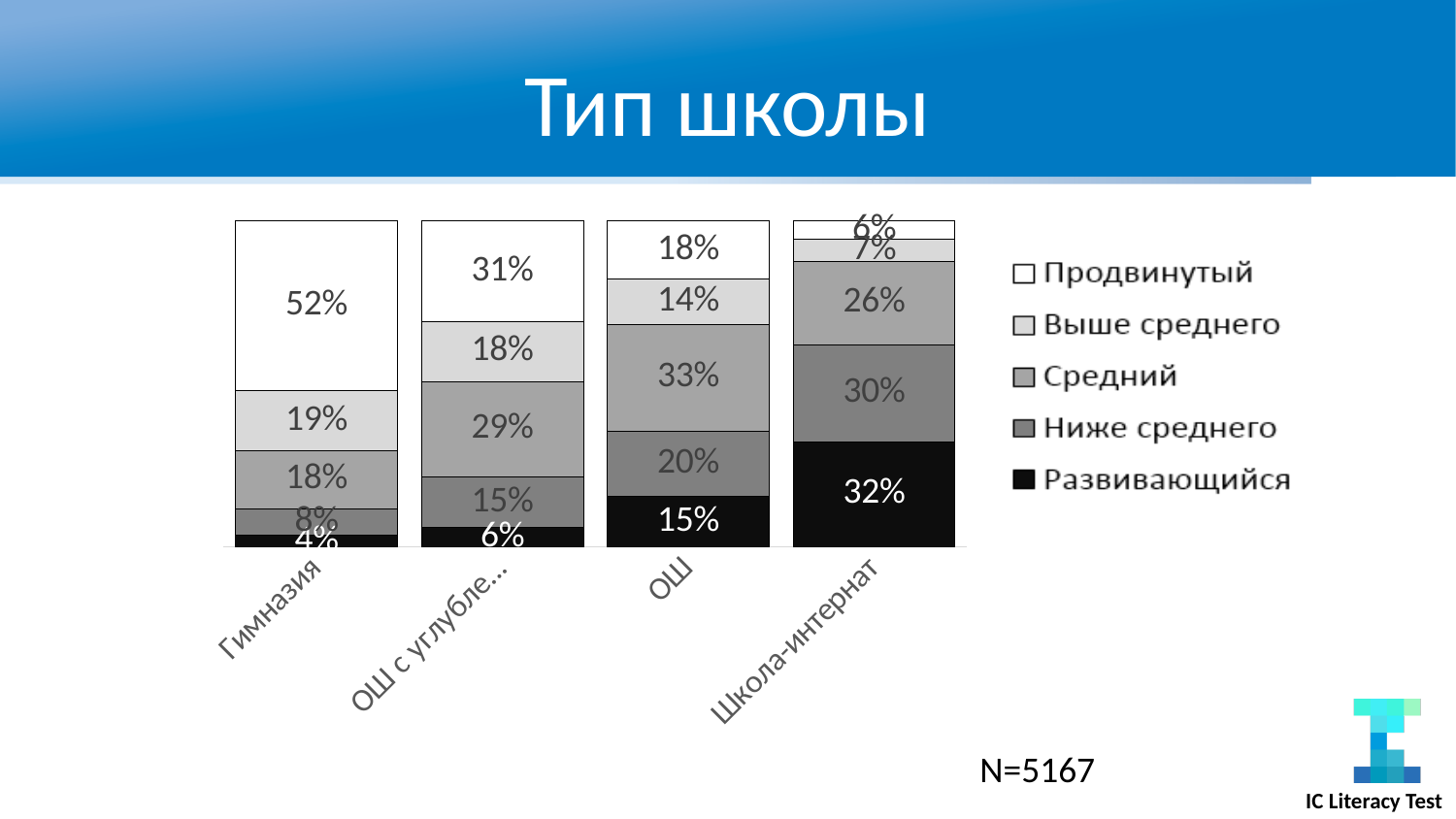
What is the difference between the Продвинутый values for Гимназия and ОШ? 34 percentage points Which has a larger Средний value, ОШ or Гимназия? ОШ How many school types (categories) are shown on the x axis? 4 What is the value of Развивающийся for ОШ? 15% Which school type has the highest share of Продвинутый? Гимназия What is the value of Продвинутый for Гимназия? 52% What is the value of Ниже среднего for ОШ? 20% What is the value of Средний for Школа-интернат? 26% Which school type has the lowest share of Развивающийся? Гимназия Which legend entry corresponds to the black segments at the bottom of the bars? Развивающийся What kind of chart is shown on the slide? Stacked bar chart How many series does the legend list? 5